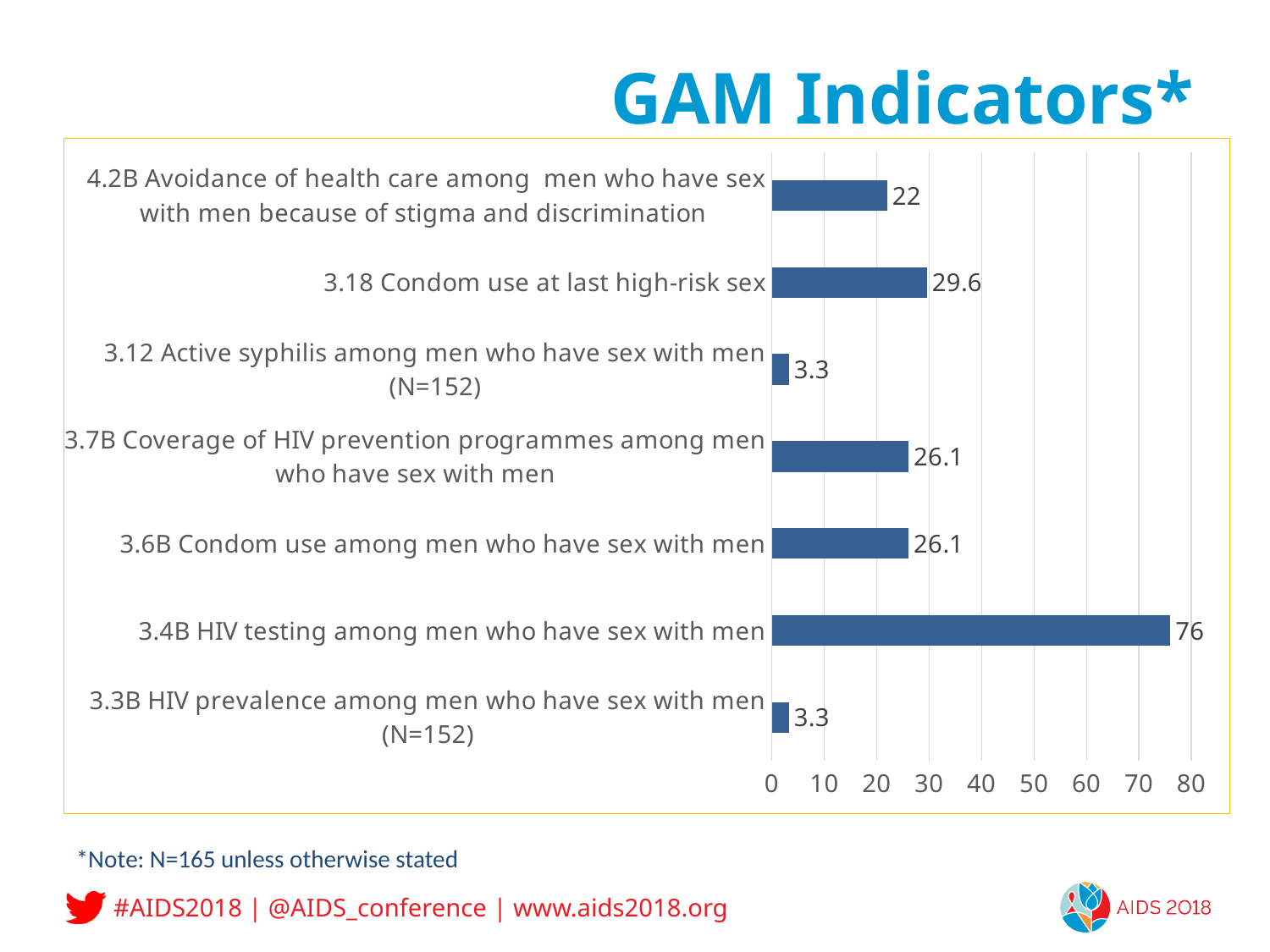
What is the value for 3.12 Active syphilis among men who have sex with men (N=152)? 3.3 Which indicator has the highest value? 3.4B HIV testing among men who have sex with men Which is larger: the value for 3.18 Condom use at last high-risk sex or the value for 3.7B Coverage of HIV prevention programmes among men who have sex with men? 3.18 Condom use at last high-risk sex Is the value for 3.4B HIV testing among men who have sex with men greater or less than 70? greater What is the title of the chart? GAM Indicators* What is the value for 3.18 Condom use at last high-risk sex? 29.6 What is the value for 3.4B HIV testing among men who have sex with men? 76 How many indicators are plotted in the chart? 7 What is the difference between the value for 3.18 Condom use at last high-risk sex and the value for 4.2B Avoidance of health care among men who have sex with men because of stigma and discrimination? 7.6 What is the value for 4.2B Avoidance of health care among men who have sex with men because of stigma and discrimination? 22 What is the difference between the value for 3.4B HIV testing among men who have sex with men and the value for 3.18 Condom use at last high-risk sex? 46.4 What kind of chart is shown on the slide? bar chart